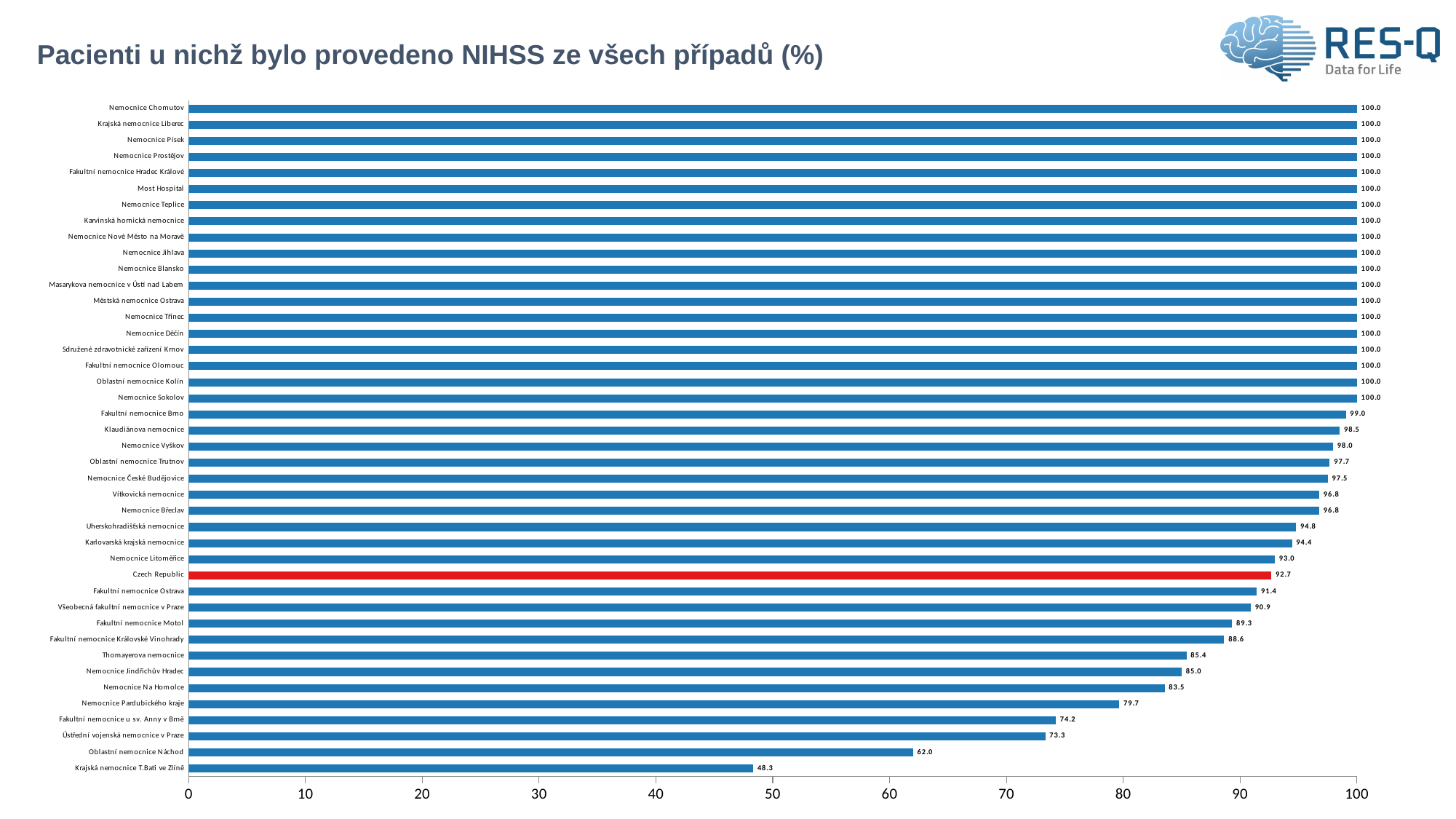
Which is larger, the value for Thomayerova nemocnice or the value for Nemocnice Pardubického kraje? Thomayerova nemocnice What kind of chart is shown on the slide? bar chart What is the difference between the values for Czech Republic and Nemocnice Na Homolce? 9.2 What is the value for Czech Republic? 92.7 What is the difference between the values for Fakultní nemocnice Brno and Fakultní nemocnice u sv. Anny v Brně? 24.8 What is the value for Fakultní nemocnice Motol? 89.3 What is the value for Oblastní nemocnice Náchod? 62.0 What is the value for Krajská nemocnice T.Bati ve Zlíně? 48.3 How many hospitals/categories are shown on the chart? 42 Is the value for Ústřední vojenská nemocnice v Praze greater or less than 80? less Which hospital has the lowest value? Krajská nemocnice T.Bati ve Zlíně Which bar is highlighted in red? Czech Republic